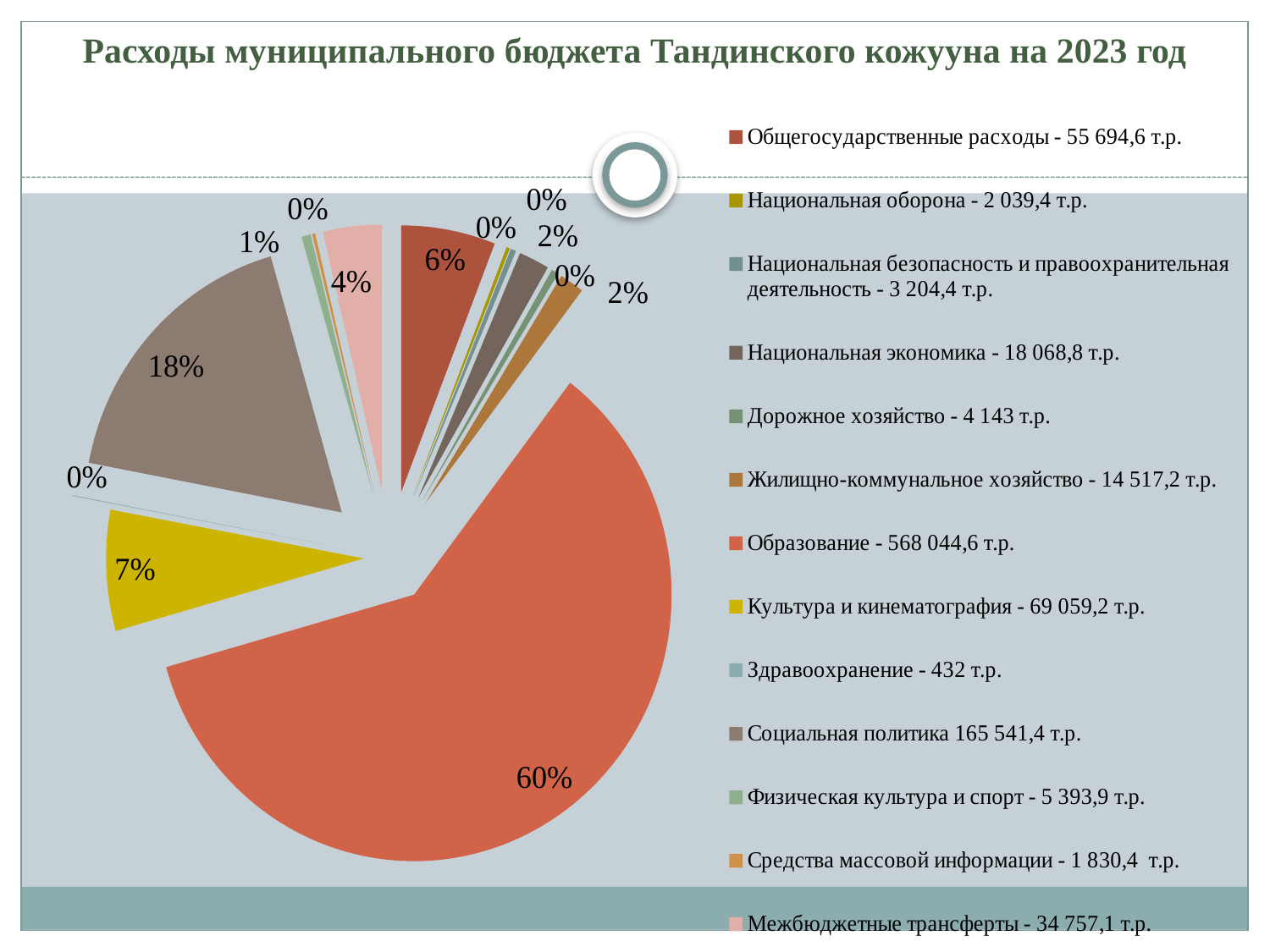
What is the title of the chart? Расходы муниципального бюджета Тандинского кожууна на 2023 год What share of the pie does Общегосударственные расходы take? 6% What share of the pie does Культура и кинематография take? 7% Which category has the smallest amount listed in the legend? Здравоохранение What kind of chart is shown on the slide? Pie chart What share of the pie does Образование take? 60% What amount is listed in the legend for Образование? 568 044,6 т.р. What amount is listed in the legend for Межбюджетные трансферты? 34 757,1 т.р. How many categories does the legend list? 13 Which category has the largest slice of the pie? Образование Which is larger, the slice for Социальная политика or the slice for Культура и кинематография? Социальная политика